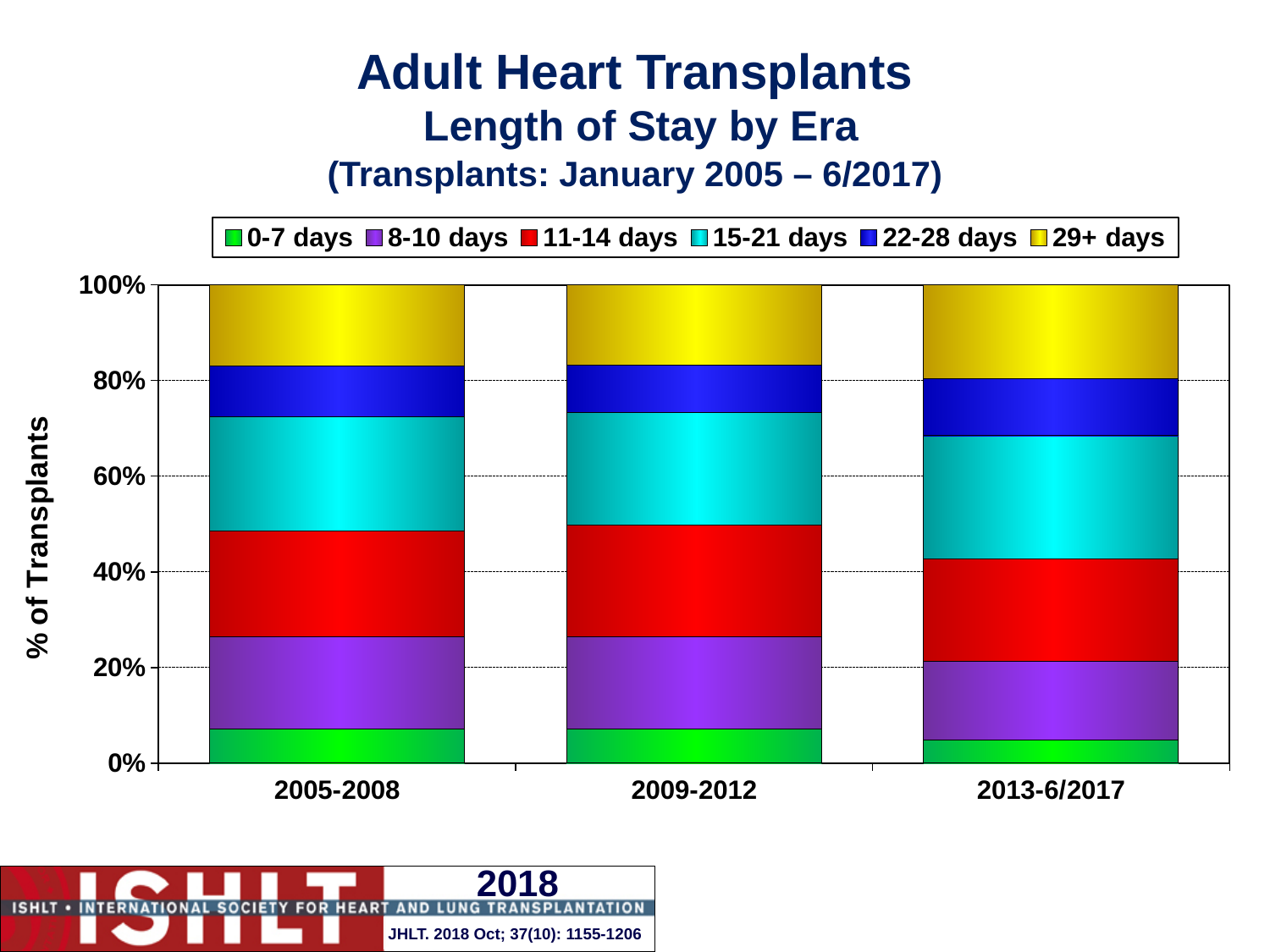
Which era has the largest share of 29+ days stays? 2013-6/2017 How many era categories are shown on the x axis? 3 How many series does the legend list? 6 Is the cumulative top of the 15-21 days segment for 2013-6/2017 greater or less than 80%? less Is the cumulative top of the 15-21 days segment for 2009-2012 greater or less than 60%? greater Which era has the larger share of 29+ days stays, 2005-2008 or 2013-6/2017? 2013-6/2017 Which legend entry is shown in yellow? 29+ days Is the cumulative top of the 11-14 days segment for 2005-2008 greater or less than 40%? greater What is the label of the y axis? % of Transplants What kind of chart is shown on the slide? Stacked bar chart What is the total height of the stacked bar for 2009-2012? 100%